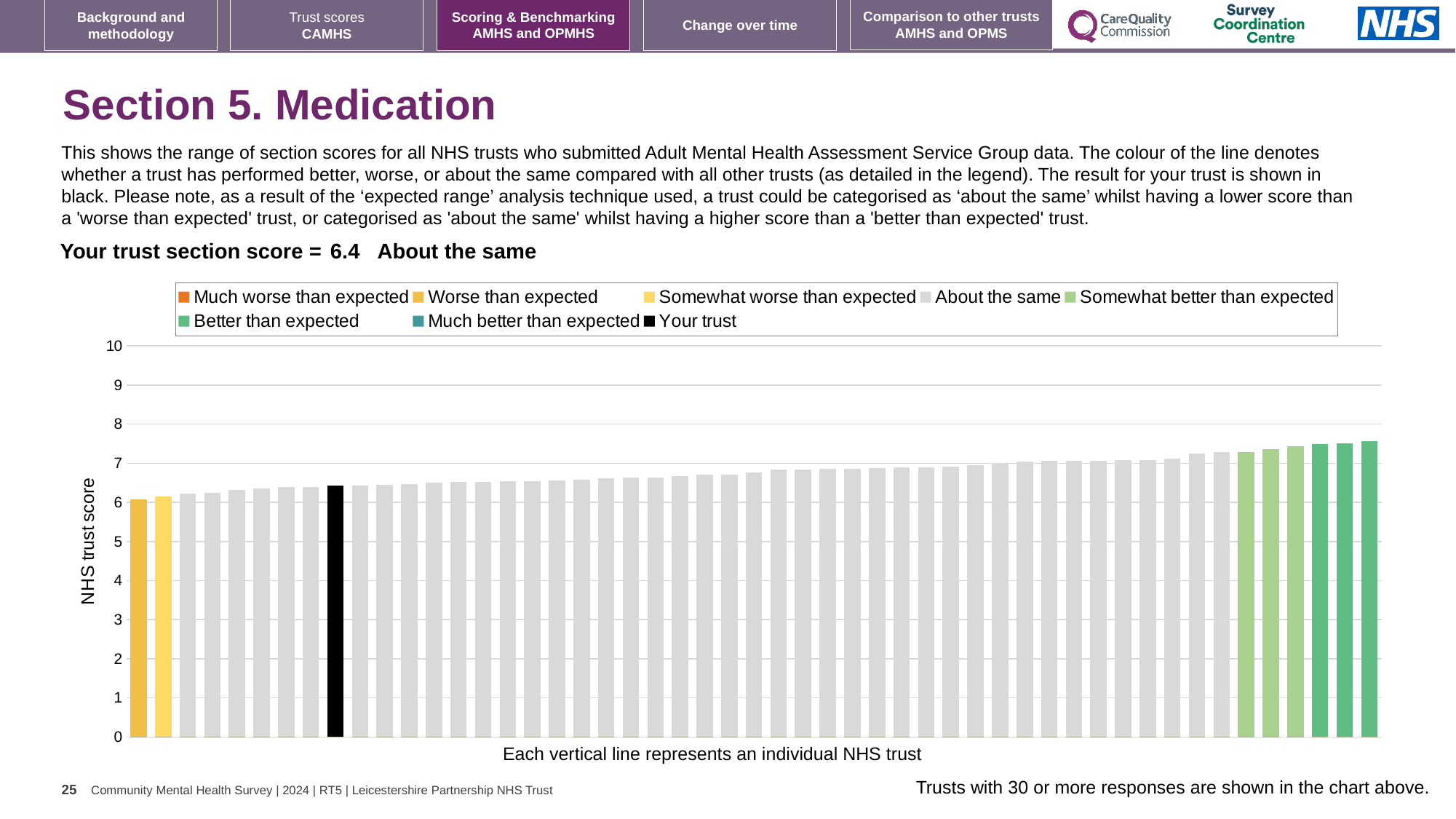
What colour is the bar representing your trust in the chart? black What is the label on the vertical axis of the chart? NHS trust score Is the value of the black 'Your trust' bar greater or less than 5? greater Is the 'Your trust' bar taller or shorter than the leftmost bar in the chart? taller What is the section score for your trust shown on the slide? 6.4 What kind of chart is shown on the slide? bar chart Which category is your trust placed in for this section? About the same How many entries does the chart legend list? 8 Is the value of the leftmost bar in the chart greater or less than 7? less Do the bar values rise or fall from left to right across the chart? rise Is the value of the tallest bar in the chart greater or less than 8? less